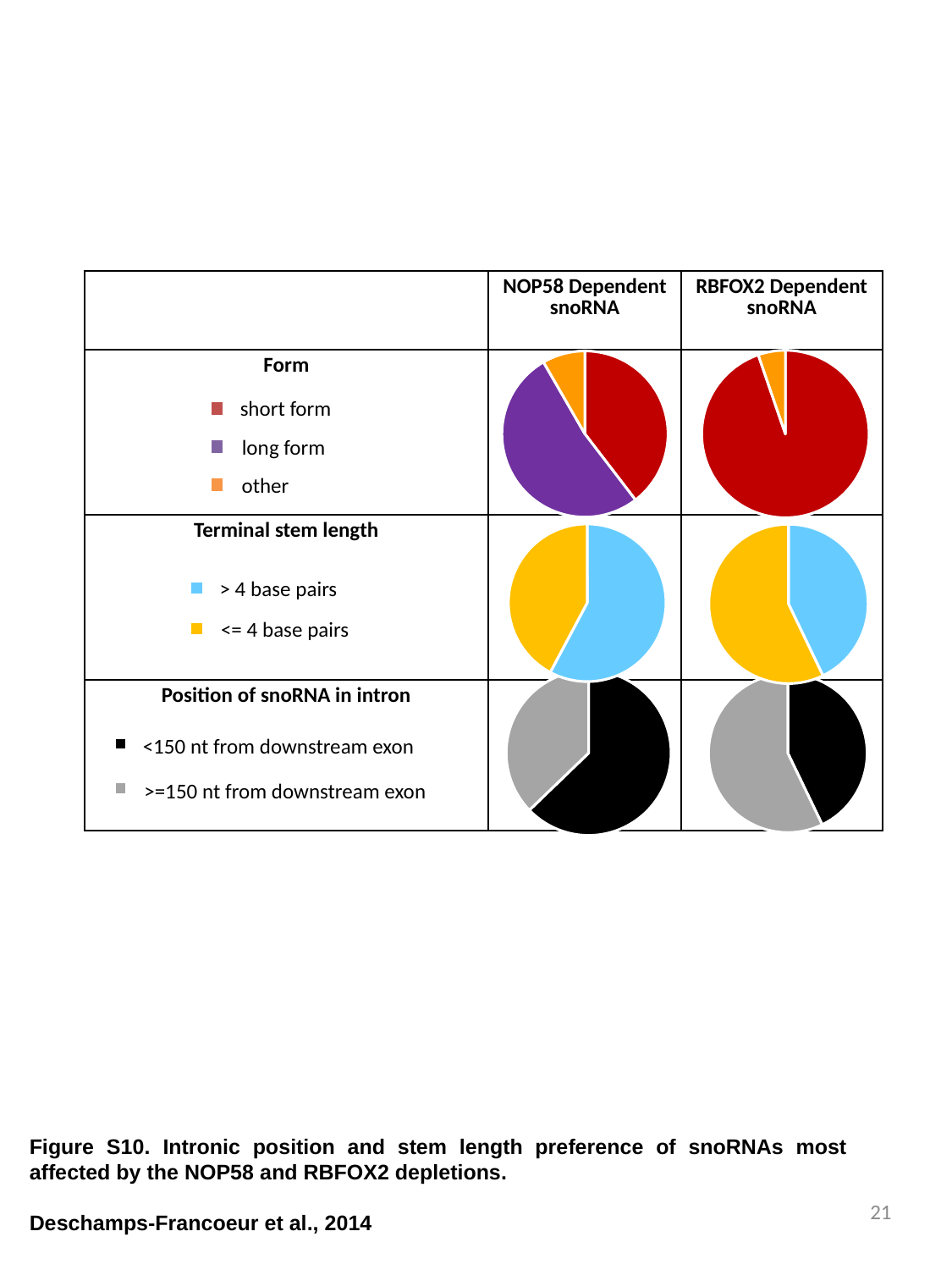
In the Form pie charts, what colour represents short form? Red In the Terminal stem length pie chart for RBFOX2 Dependent snoRNA, which is larger: > 4 base pairs or <= 4 base pairs? <= 4 base pairs In the Position of snoRNA in intron pie chart for NOP58 Dependent snoRNA, which category has the larger slice? <150 nt from downstream exon In the Form pie chart for RBFOX2 Dependent snoRNA, which category has the largest slice? short form How many categories does the legend for the Form pie charts list? 3 How many pie charts are shown on the slide? 6 In the Form pie chart for NOP58 Dependent snoRNA, which category has the smallest slice? other In the Form pie chart for NOP58 Dependent snoRNA, which category has the largest slice? long form What kind of charts are shown in the table on the slide? Pie charts What are the two column headings above the pie charts? NOP58 Dependent snoRNA and RBFOX2 Dependent snoRNA In the Terminal stem length pie chart for NOP58 Dependent snoRNA, which is larger: > 4 base pairs or <= 4 base pairs? > 4 base pairs